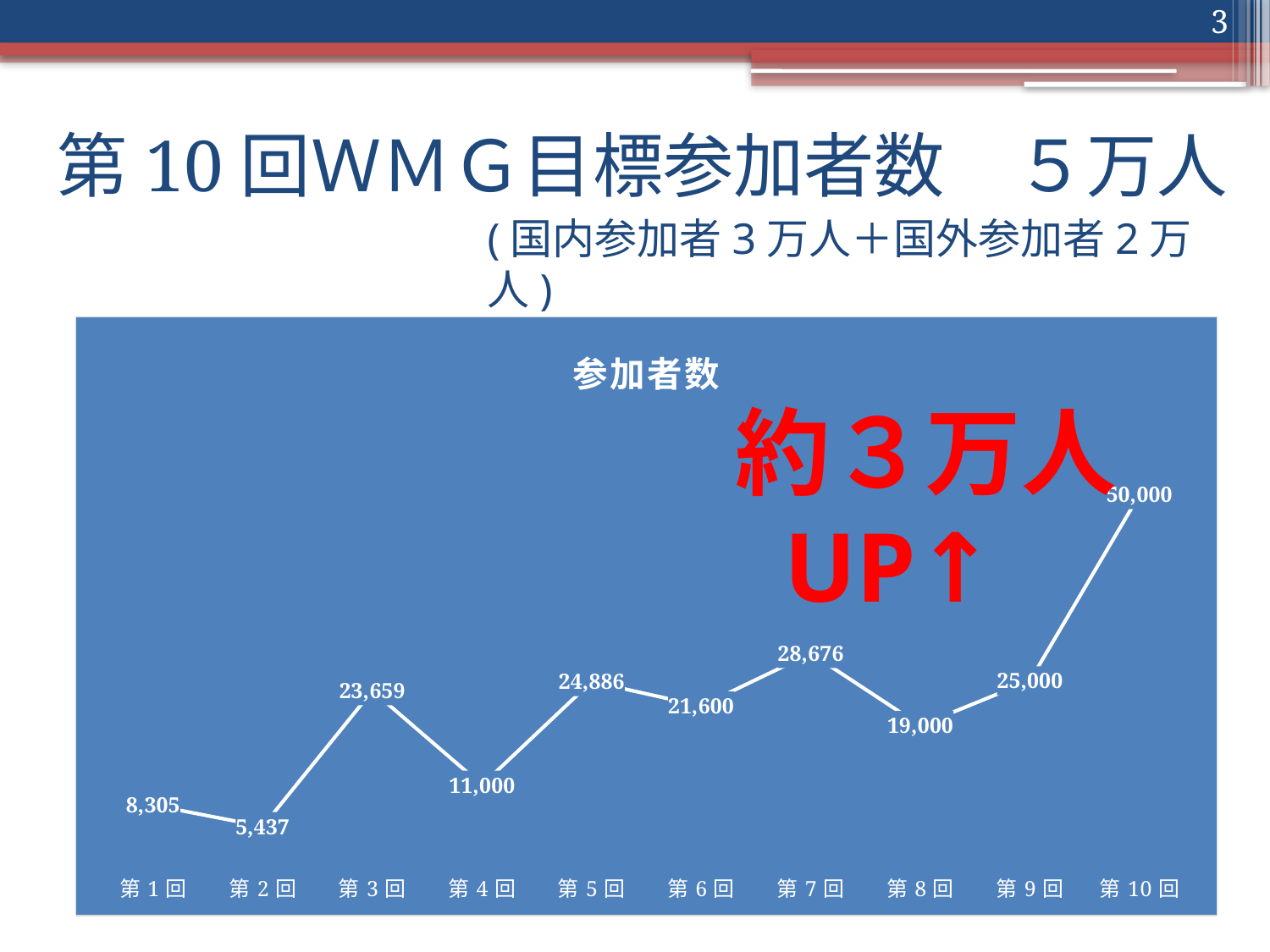
Does the value rise or fall from 第7回 to 第8回 in the 参加者数 chart? fall What is the title of the chart on the slide? 参加者数 What is the value for 第7回 in the 参加者数 chart? 28,676 How many categories are plotted along the x axis of the 参加者数 chart? 10 Which is larger in the 参加者数 chart, the value for 第5回 or the value for 第6回? 第5回 Which category has the lowest value in the 参加者数 chart? 第2回 Which category has the highest value in the 参加者数 chart? 第10回 What is the value for 第4回 in the 参加者数 chart? 11,000 What kind of chart is shown on the slide? line chart What is the value for 第1回 in the 参加者数 chart? 8,305 What is the difference between the values for 第10回 and 第9回 in the 参加者数 chart? 25,000 What is the difference between the values for 第3回 and 第4回 in the 参加者数 chart? 12,659